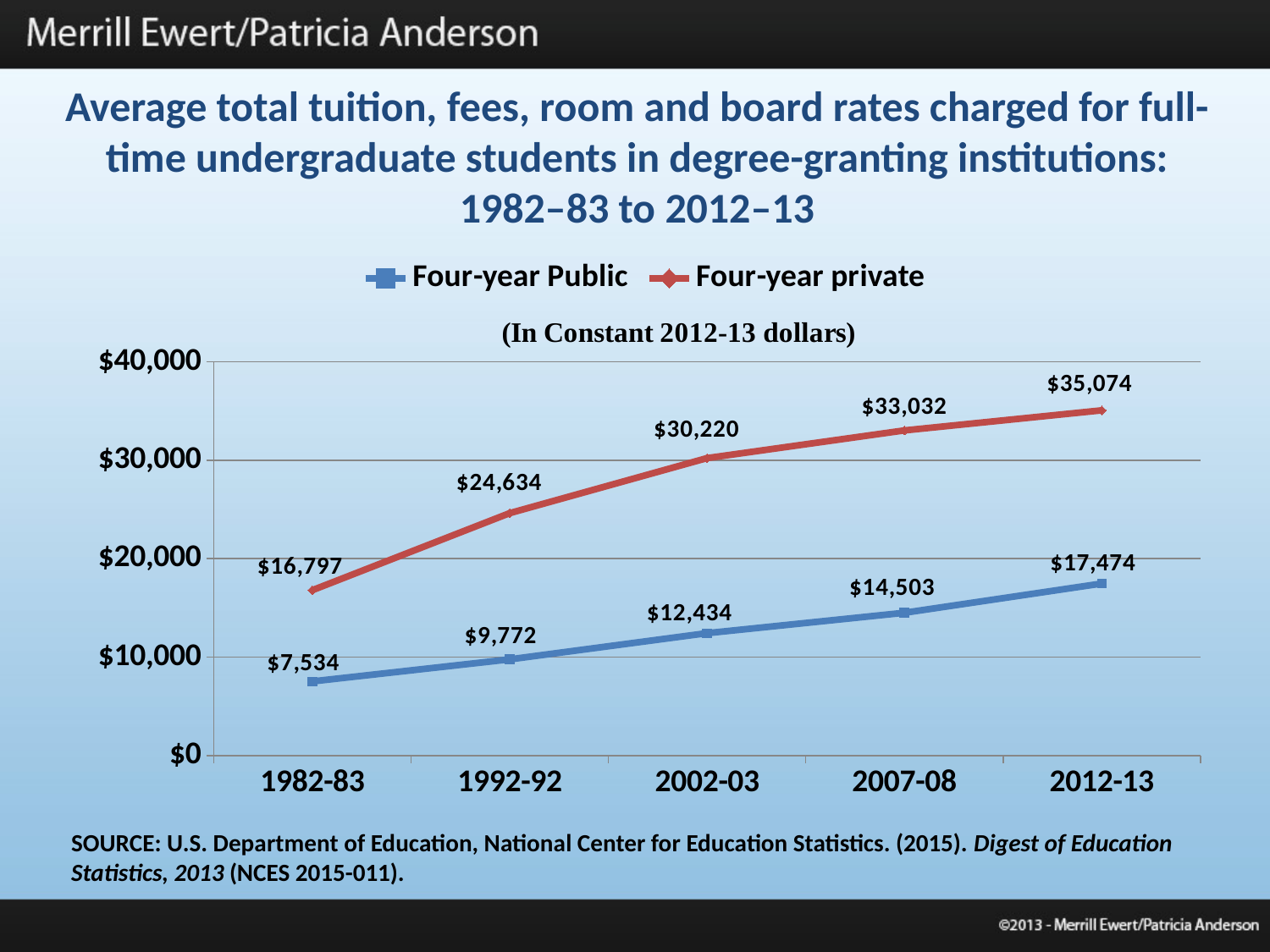
How many time periods are shown on the x axis? 5 In which year is the Four-year private value lowest? 1982-83 What is the Four-year private value for 2002-03? $30,220 What is the difference between the Four-year private and Four-year Public values in 2012-13? $17,600 Do the Four-year private values rise or fall from 1982-83 to 2012-13? Rise How many series does the legend list? 2 What kind of chart is shown on the slide? Line chart What is the Four-year private value for 2012-13? $35,074 What is the Four-year Public value for 1982-83? $7,534 In which year is the Four-year Public value highest? 2012-13 Which is larger in 1992-92, the Four-year Public value or the Four-year private value? Four-year private What is the Four-year Public value for 2007-08? $14,503